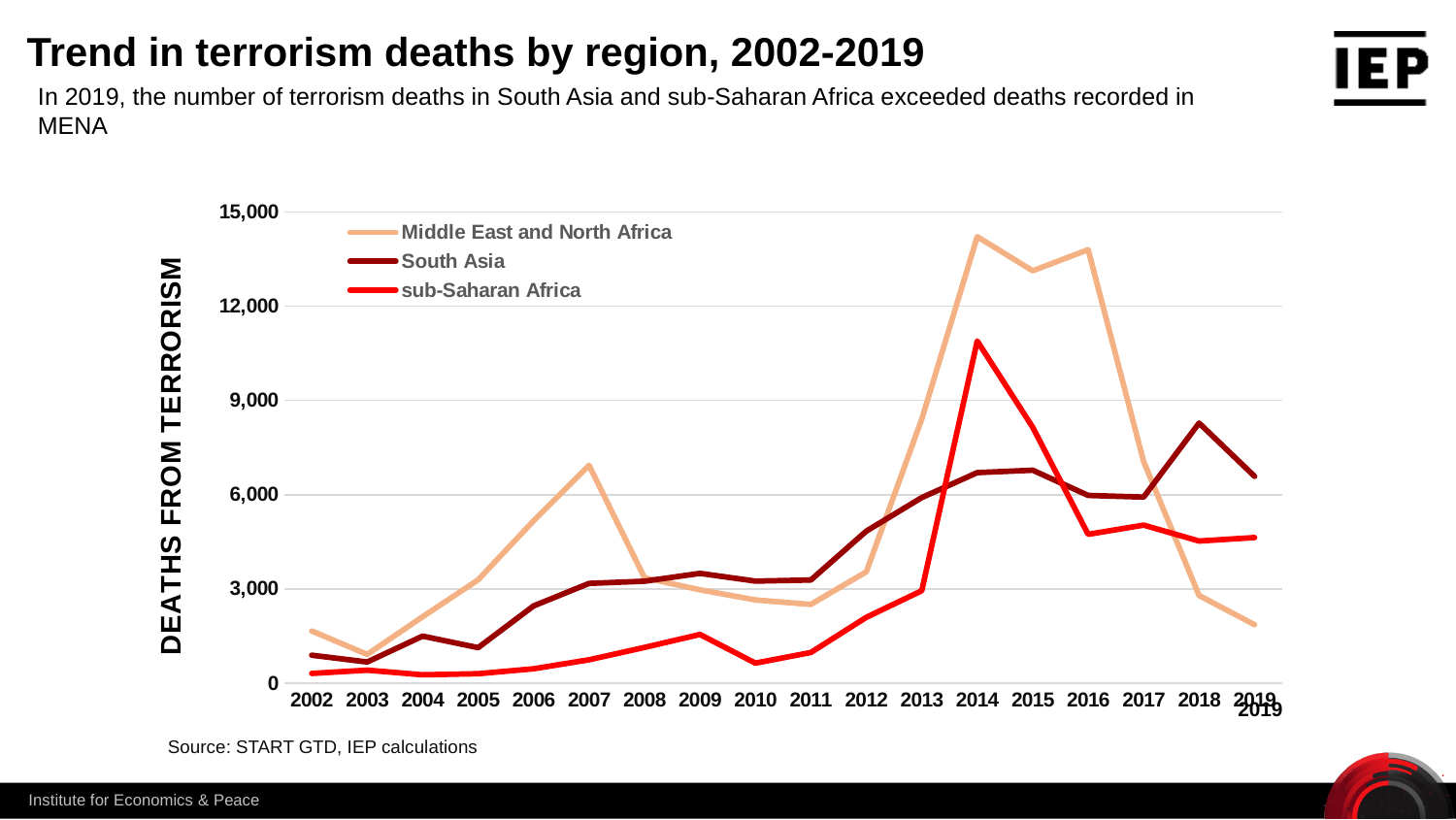
What is the label on the y axis? DEATHS FROM TERRORISM In which year does the South Asia series reach its highest value? 2018 Is the value for Middle East and North Africa in 2019 greater or less than 3,000? less How many series does the legend list? 3 Which series reaches the highest value on the chart? Middle East and North Africa Is the value for Middle East and North Africa in 2014 greater or less than 12,000? greater Does the Middle East and North Africa series rise or fall from 2016 to 2019? fall How many years are plotted along the x axis? 18 What kind of chart is shown on the slide? line chart Is the value for sub-Saharan Africa in 2014 greater or less than 9,000? greater In 2019, which is larger: South Asia or Middle East and North Africa? South Asia In which year does the Middle East and North Africa series reach its highest value? 2014